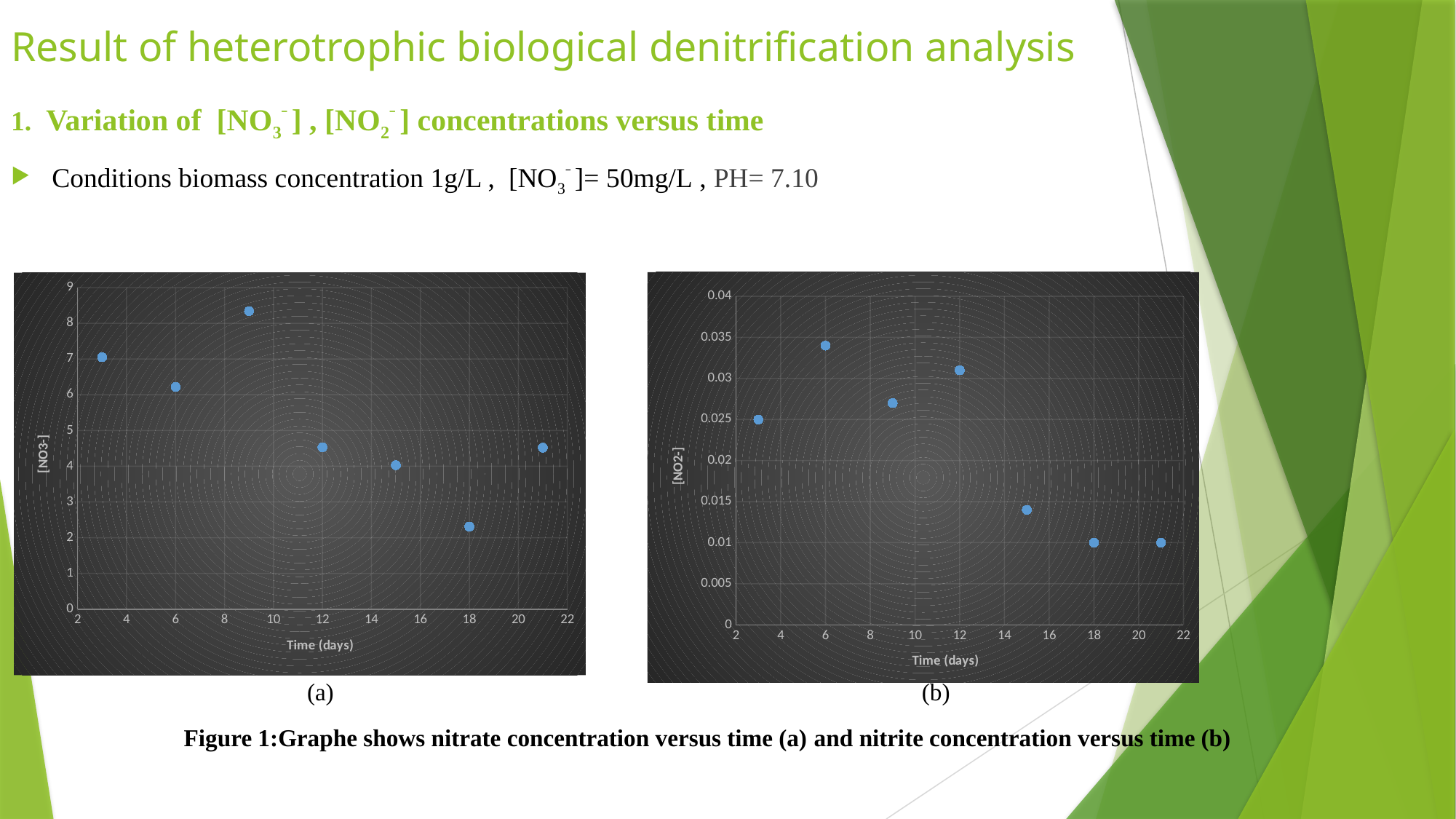
In chart (a), at which time (days) is the [NO3-] value lowest? 18 In chart (a), at which time (days) is the [NO3-] value highest? 9 In chart (a), which has the larger [NO3-] value, day 6 or day 12? day 6 In chart (b), is the [NO2-] value at day 6 greater or less than 0.03? greater What kind of chart is chart (a), on the left of the slide? scatter chart In chart (b), which has the larger [NO2-] value, day 3 or day 15? day 3 In chart (a), is the [NO3-] value at day 18 greater or less than 3? less In chart (b), how many data points are plotted? 7 In chart (b), do the [NO2-] values overall rise or fall from day 12 to day 21? fall What is the x-axis title of chart (b)? Time (days) In chart (b), at which time (days) is the [NO2-] value highest? 6 In chart (a), how many data points are plotted? 7